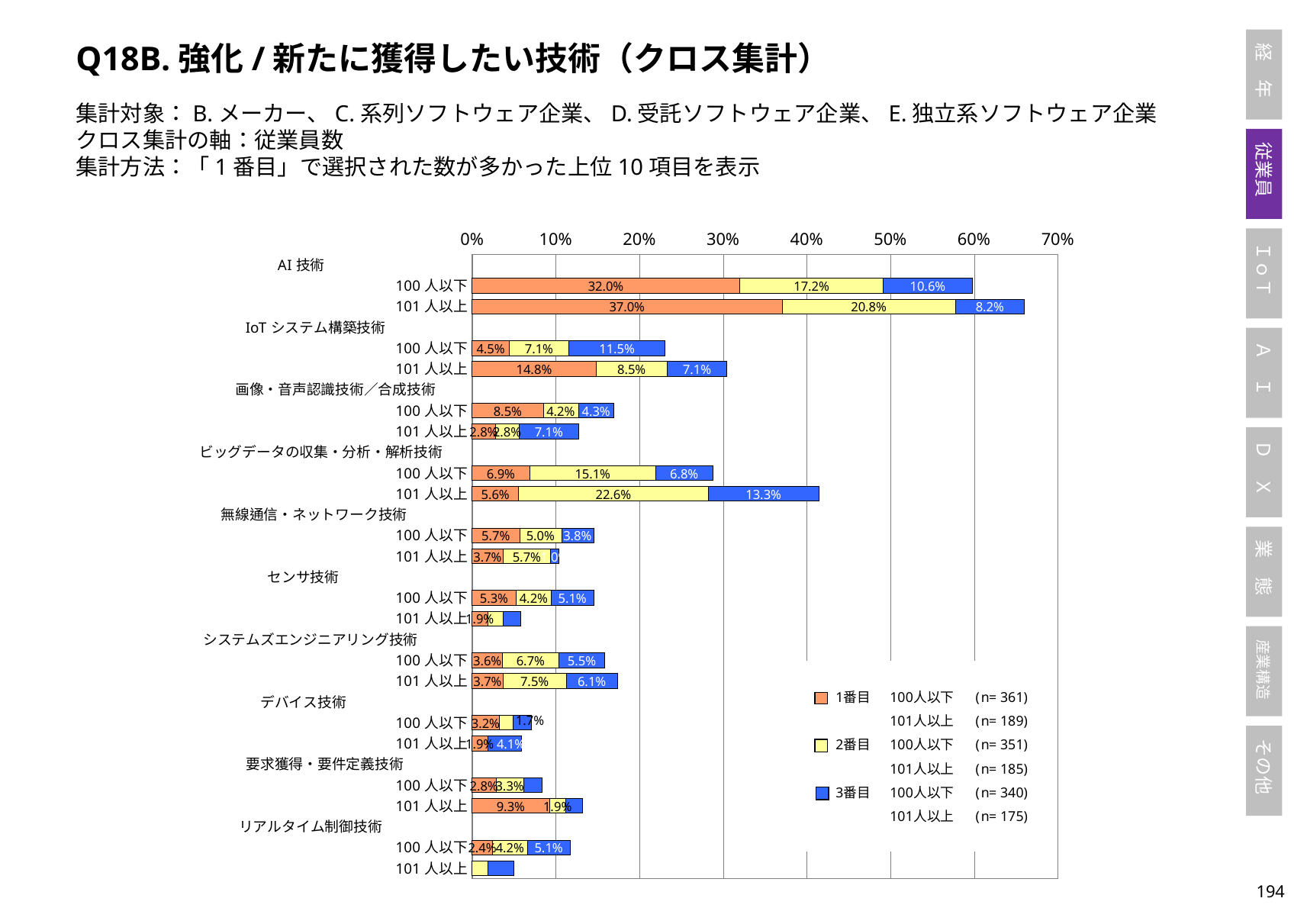
According to the legend, what is the n for 1番目, 100人以下? 361 How many technology categories are shown in the chart? 10 What is the total of the stacked bar for AI 技術, 100 人以下? 59.8% What is the 2番目 value for ビッグデータの収集・分析・解析技術 among companies with 101 人以上? 22.6% What is the total of the stacked bar for AI 技術, 101 人以上? 66.0% What is the 1番目 value for IoT システム構築技術 among companies with 101 人以上? 14.8% What kind of chart is shown on the slide? Stacked bar chart How many series does the legend list? 3 What is the 1番目 value for AI 技術 among companies with 100 人以下? 32.0% What is the 1番目 value for AI 技術 among companies with 101 人以上? 37.0% Which bar is the longest in the chart? AI 技術, 101 人以上 What is the difference between the 1番目 values for AI 技術 between 101 人以上 and 100 人以下? 5.0 percentage points